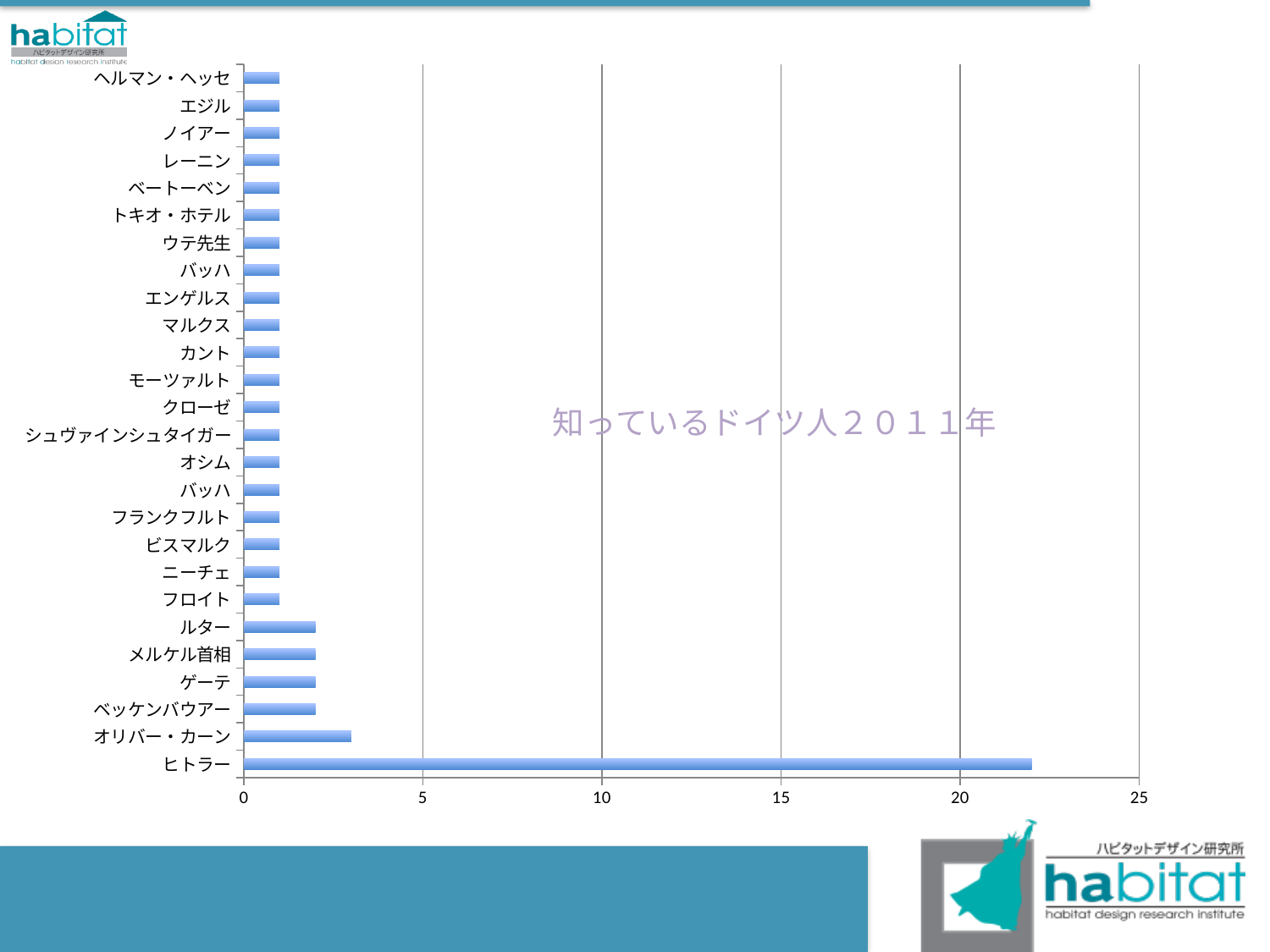
Which is larger, the value for ルター or the value for フロイト? ルター Which category has the highest value? ヒトラー Which is larger, the value for ヒトラー or the value for オリバー・カーン? ヒトラー Is the value for ヒトラー greater or less than 25? less How many categories are plotted on the chart? 26 What is the title of the chart? 知っているドイツ人２０１１年 Which is larger, the value for オリバー・カーン or the value for ベッケンバウアー? オリバー・カーン What is the maximum value shown on the horizontal axis? 25 What kind of chart is shown on the slide? bar chart Is the value for オリバー・カーン greater or less than 5? less Is the value for ヒトラー greater or less than 20? greater